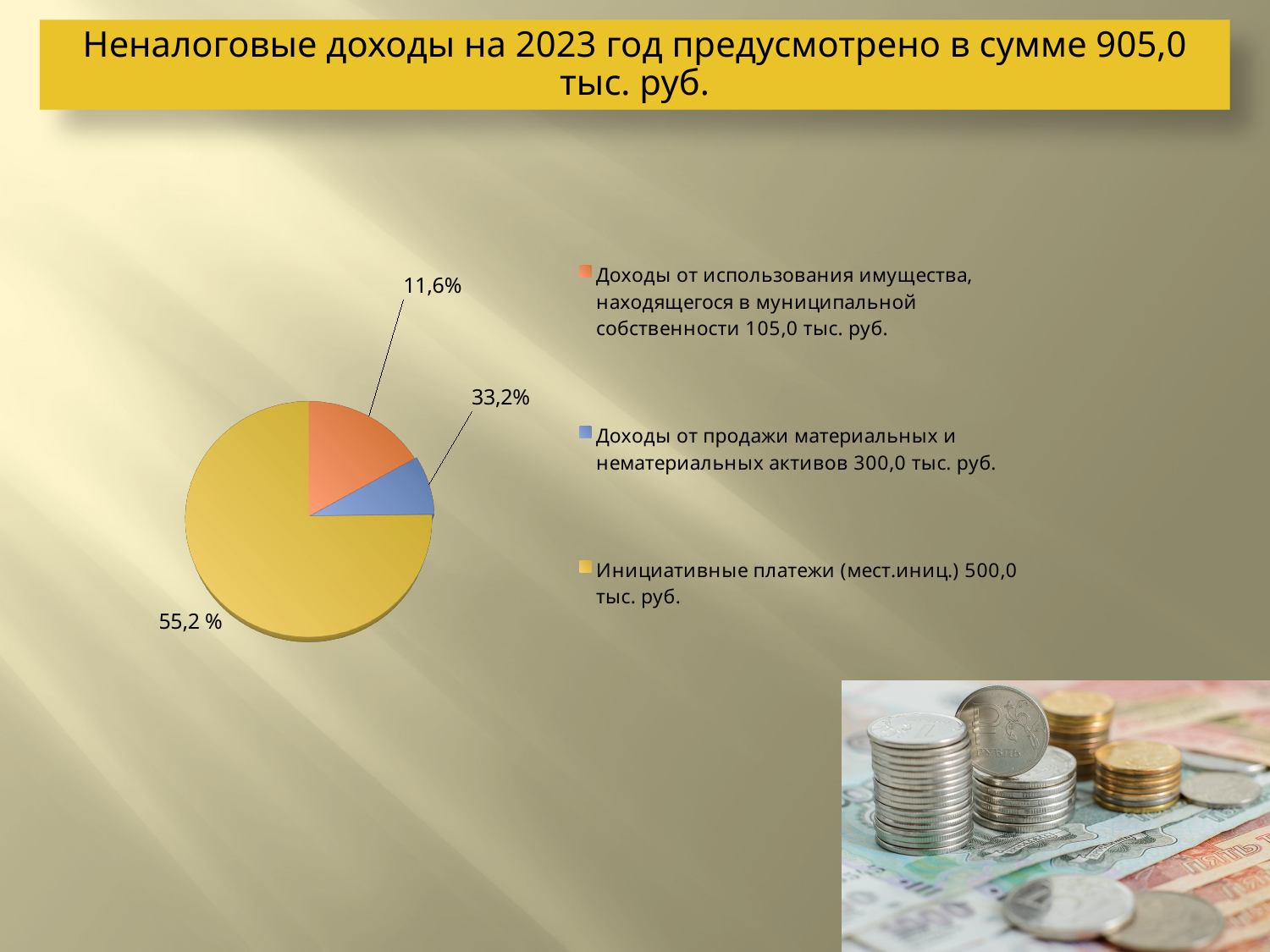
What share of the pie is labelled for Доходы от использования имущества, находящегося в муниципальной собственности? 11,6% According to the legend, what amount is given for Доходы от использования имущества, находящегося в муниципальной собственности? 105,0 тыс. руб. What share of the pie is labelled for Инициативные платежи (мест.иниц.)? 55,2 % What total sum of non-tax revenues for 2023 is stated in the slide title? 905,0 тыс. руб. What is the difference between the amounts for Инициативные платежи (мест.иниц.) and Доходы от использования имущества, находящегося в муниципальной собственности? 395,0 тыс. руб. How many slices does the pie chart have? 3 What share of the pie is labelled for Доходы от продажи материальных и нематериальных активов? 33,2% According to the legend, what amount is given for Инициативные платежи (мест.иниц.)? 500,0 тыс. руб. Which category has the largest slice of the pie? Инициативные платежи (мест.иниц.) What kind of chart is shown on the slide? Pie chart According to the legend, what amount is given for Доходы от продажи материальных и нематериальных активов? 300,0 тыс. руб. Which is larger: Инициативные платежи (мест.иниц.) or Доходы от продажи материальных и нематериальных активов? Инициативные платежи (мест.иниц.)